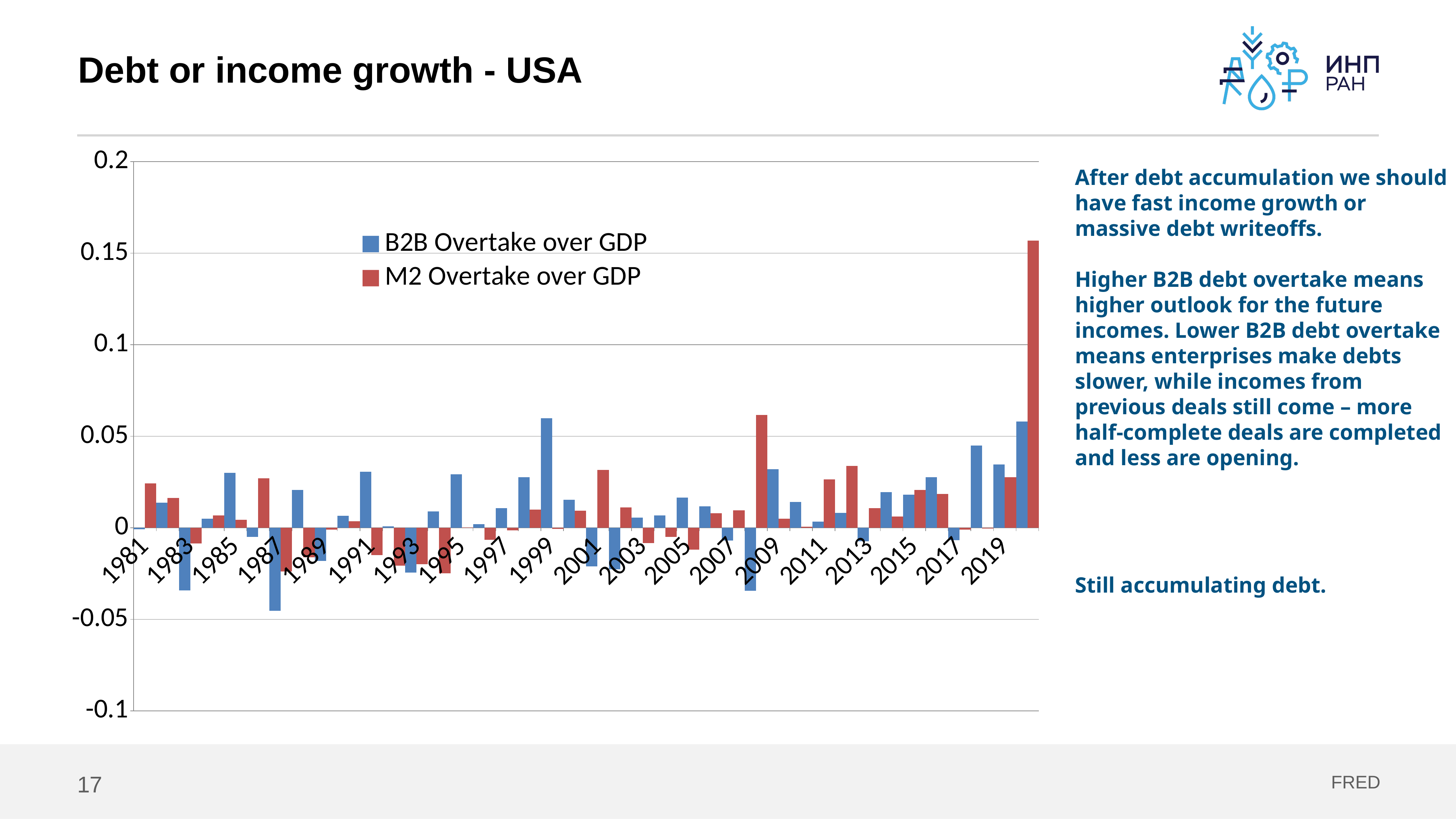
In 1999, which series has the larger value, B2B Overtake over GDP or M2 Overtake over GDP? B2B Overtake over GDP How many year labels are shown on the x axis? 20 How many series does the legend list? 2 Is the B2B Overtake over GDP value for 1987 greater or less than 0? less What colour are the bars for the M2 Overtake over GDP series? red Is the B2B Overtake over GDP value for 1983 greater or less than 0? less What are the two series named in the legend? B2B Overtake over GDP and M2 Overtake over GDP What kind of chart is shown on the slide? bar chart Is the rightmost M2 Overtake over GDP bar greater or less than 0.1? greater Which series has the tallest bar anywhere on the chart? M2 Overtake over GDP In which year does the B2B Overtake over GDP series reach its lowest value? 1987